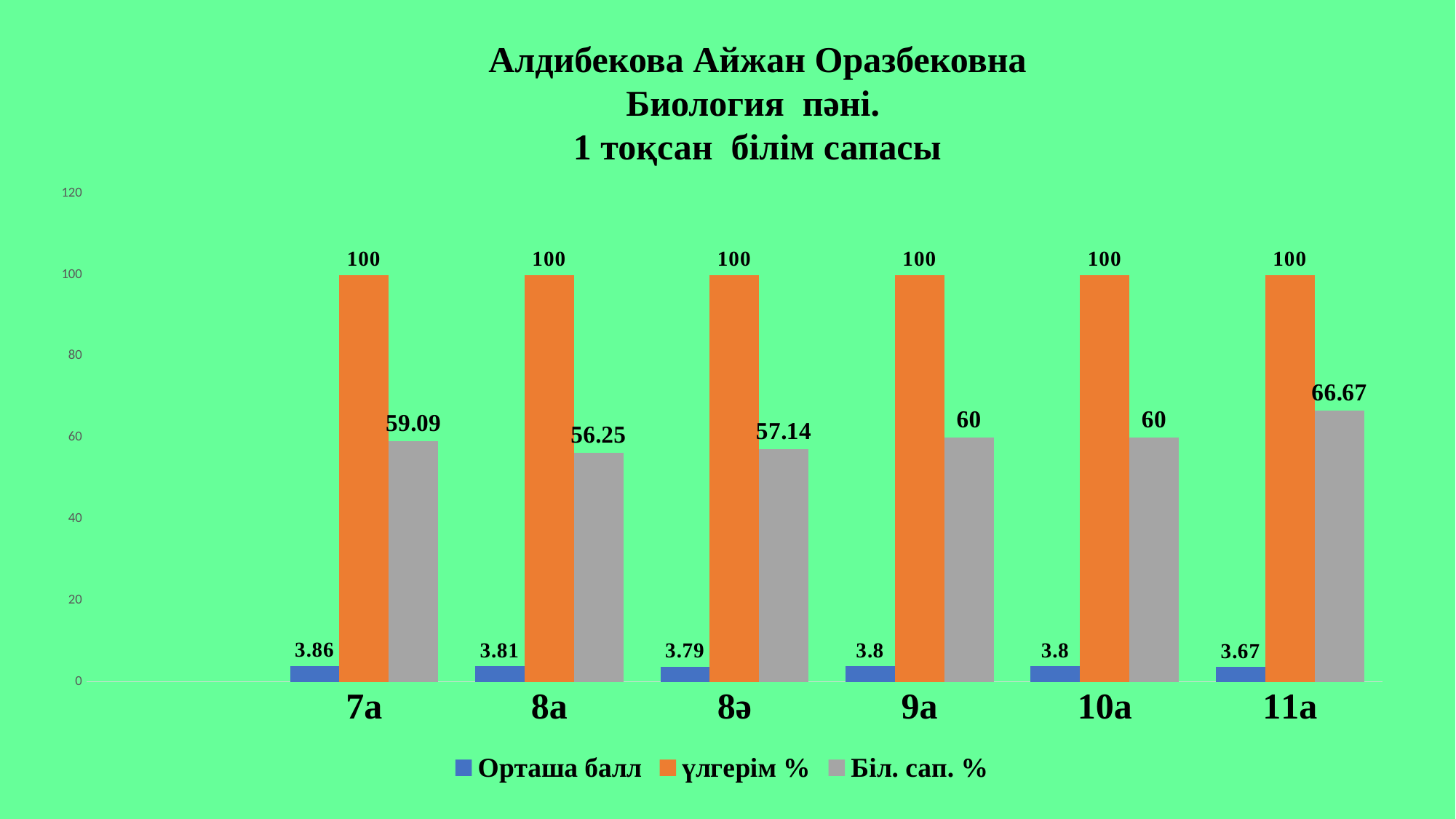
What kind of chart is shown on the slide? bar chart What is the Біл. сап. % value for 8а? 56.25 What is the difference between the Біл. сап. % values for 11а and 8а? 10.42 How many classes are shown on the x axis? 6 What is the Біл. сап. % value for 11а? 66.67 Which class has the highest Біл. сап. % value? 11а What is the Орташа балл value for 7а? 3.86 How many series does the legend list? 3 Is the Біл. сап. % value for 9а greater or less than 80? less What is the үлгерім % value for 10а? 100 Which class has the lowest Орташа балл value? 11а Which is larger, the Біл. сап. % value for 7а or for 8ә? 7а